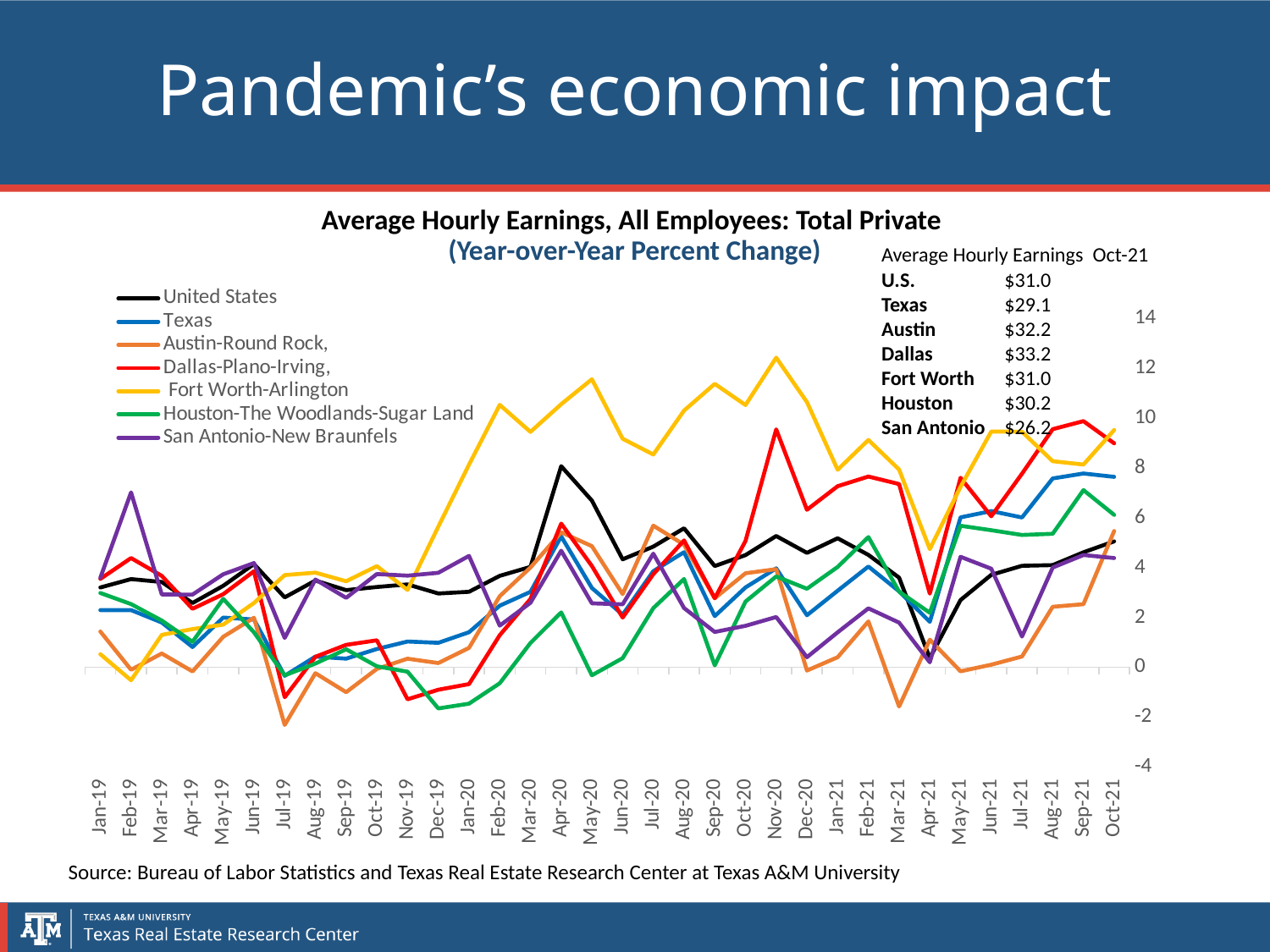
How many monthly points are shown along the x axis, from Jan-19 to Oct-21? 34 Which series has the highest value in Nov-20? Fort Worth-Arlington How many series does the legend list? 7 Is the value for Austin-Round Rock in Jul-19 greater or less than 0? less In Nov-20, which is larger: the value for Fort Worth-Arlington or the value for Houston-The Woodlands-Sugar Land? Fort Worth-Arlington Which series has the lowest value in Jul-19? Austin-Round Rock Does the Texas series rise or fall from Apr-21 to Oct-21? rise What kind of chart is shown on the slide? line chart Which series has the highest value in Feb-19? San Antonio-New Braunfels Is the value for Fort Worth-Arlington in Nov-20 greater or less than 10? greater According to the Oct-21 table on the slide, what is the average hourly earnings for Dallas? $33.2 Is the value for Houston-The Woodlands-Sugar Land in Dec-19 greater or less than 0? less